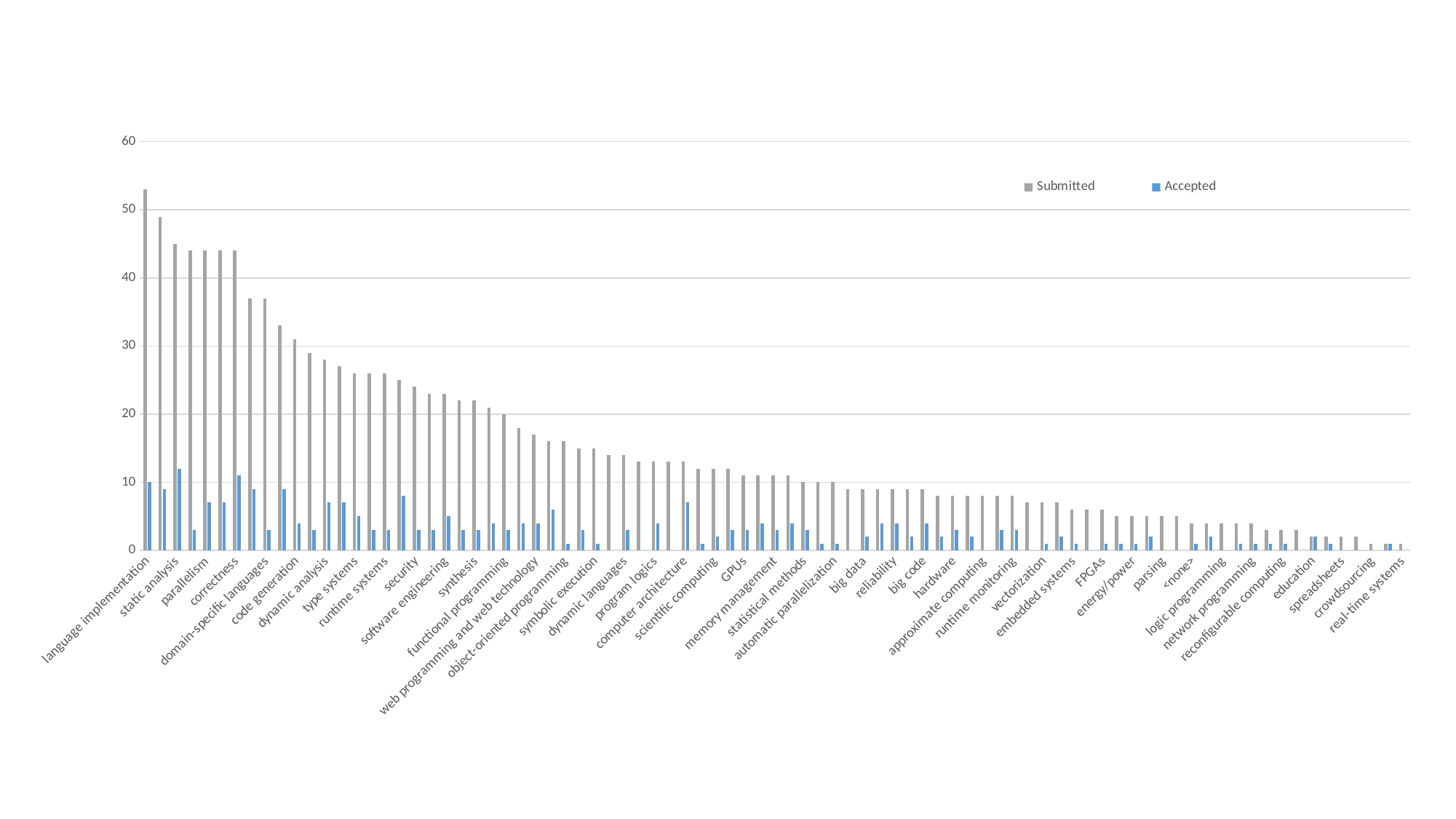
Is the Submitted value for correctness greater or less than 40? greater Is the Submitted value for real-time systems greater or less than 10? less Is the Submitted value for education greater or less than 10? less What kind of chart is shown on the slide? bar chart Which is larger for language implementation, the Submitted value or the Accepted value? Submitted Which category has the highest Submitted value? language implementation How many series does the legend list? 2 Do the Submitted values rise or fall moving from left to right along the x axis? fall Which category has the larger Submitted value, language implementation or crowdsourcing? language implementation Which colour represents the Accepted series in the legend? blue